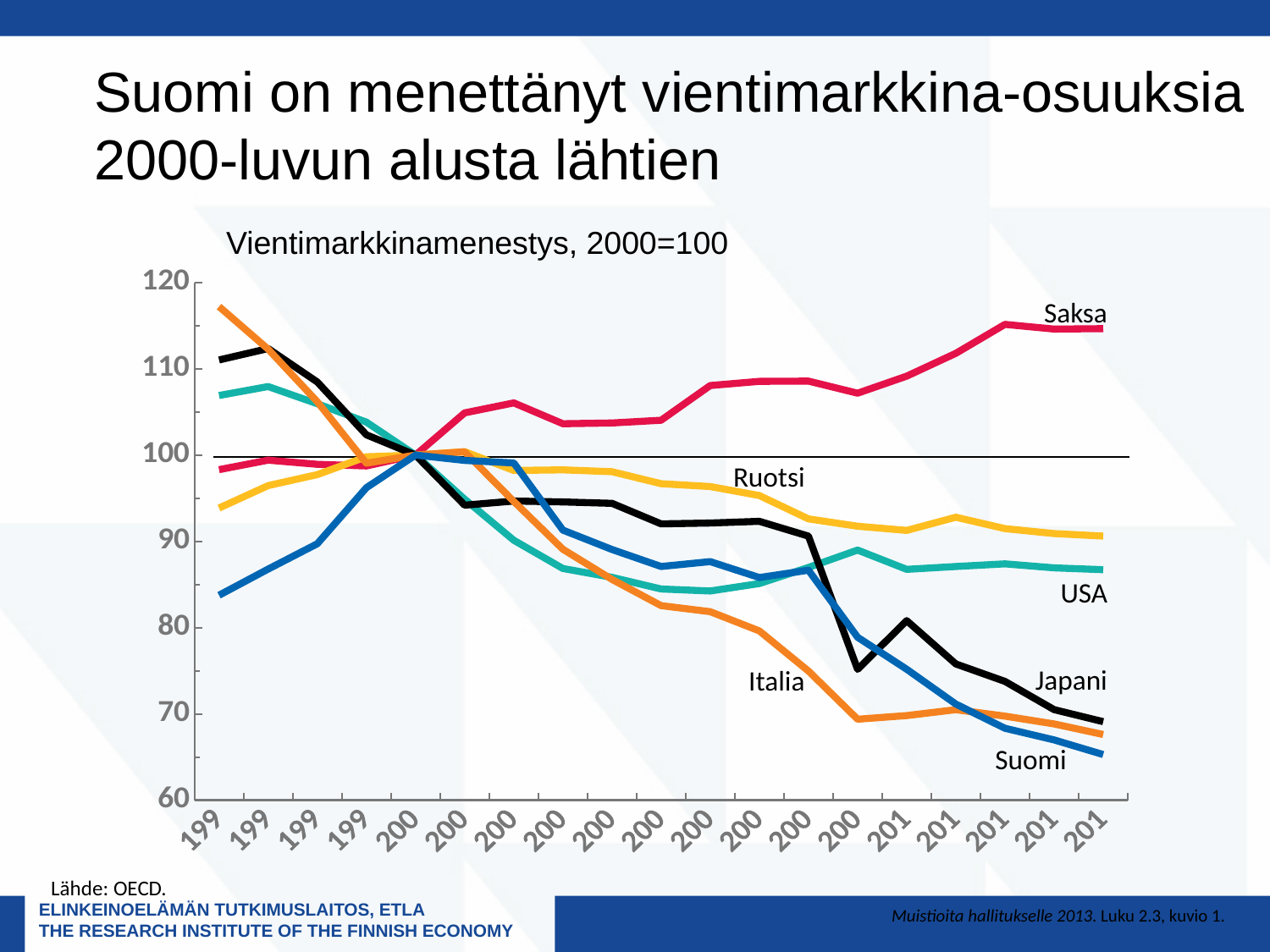
Is the final value for Saksa greater or less than 110? greater What is the title of the chart? Vientimarkkinamenestys, 2000=100 Is the first value for Italia greater or less than 110? greater Does the line for Saksa rise or fall overall from 2000 to the end of the chart? rise How many countries (series) are plotted in the chart? 6 Which country has the lowest value at the right end of the chart? Suomi What kind of chart is shown on the slide? line chart Is the final value for Suomi greater or less than 70? less Does the line for Suomi rise or fall from 2000 to the end of the chart? fall At the right end of the chart, which is larger, the value for Ruotsi or the value for USA? Ruotsi Which country has the highest value at the right end of the chart? Saksa